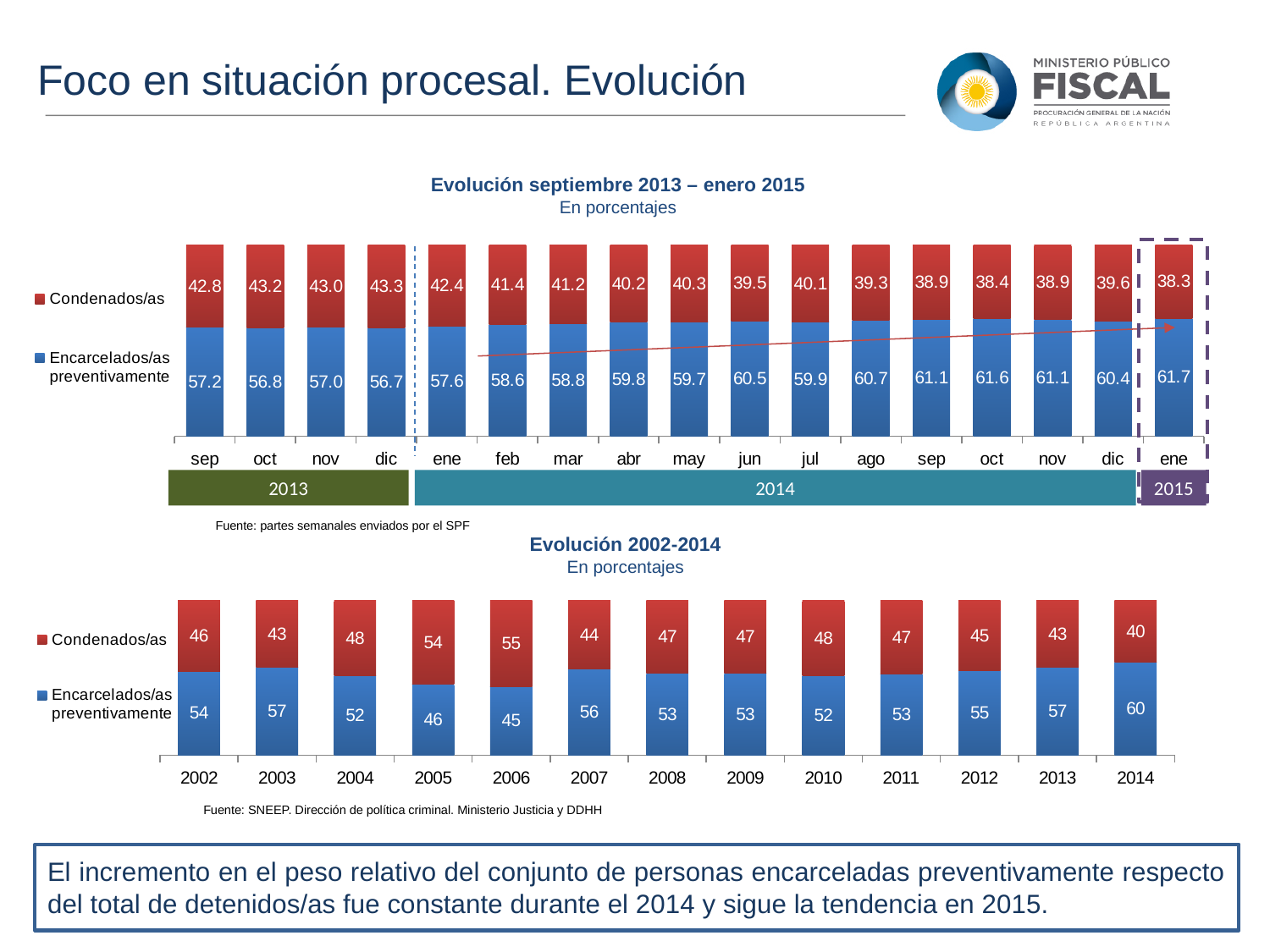
In the chart 'Evolución septiembre 2013 – enero 2015', what is the value for Encarcelados/as preventivamente in ene 2015? 61.7 In the chart 'Evolución septiembre 2013 – enero 2015', what is the difference between the Encarcelados/as preventivamente values for ene 2015 and sep 2013? 4.5 In the chart 'Evolución septiembre 2013 – enero 2015', what is the value for Condenados/as in sep 2013? 42.8 In the chart 'Evolución 2002-2014', which is larger: Condenados/as in 2005 or Condenados/as in 2014? 2005 In the chart 'Evolución septiembre 2013 – enero 2015', which month has the highest value for Encarcelados/as preventivamente? ene 2015 In the chart 'Evolución 2002-2014', what is the value for Condenados/as in 2006? 55 In the chart 'Evolución septiembre 2013 – enero 2015', does the Encarcelados/as preventivamente series generally rise or fall from sep 2013 to ene 2015? rise In the chart 'Evolución 2002-2014', which year has the highest value for Encarcelados/as preventivamente? 2014 What kind of chart is 'Evolución 2002-2014'? stacked bar chart In the chart 'Evolución septiembre 2013 – enero 2015', which month has the lowest value for Condenados/as? ene 2015 In the chart 'Evolución 2002-2014', which year has the lowest value for Encarcelados/as preventivamente? 2006 In the chart 'Evolución septiembre 2013 – enero 2015', how many months are shown on the x axis? 17